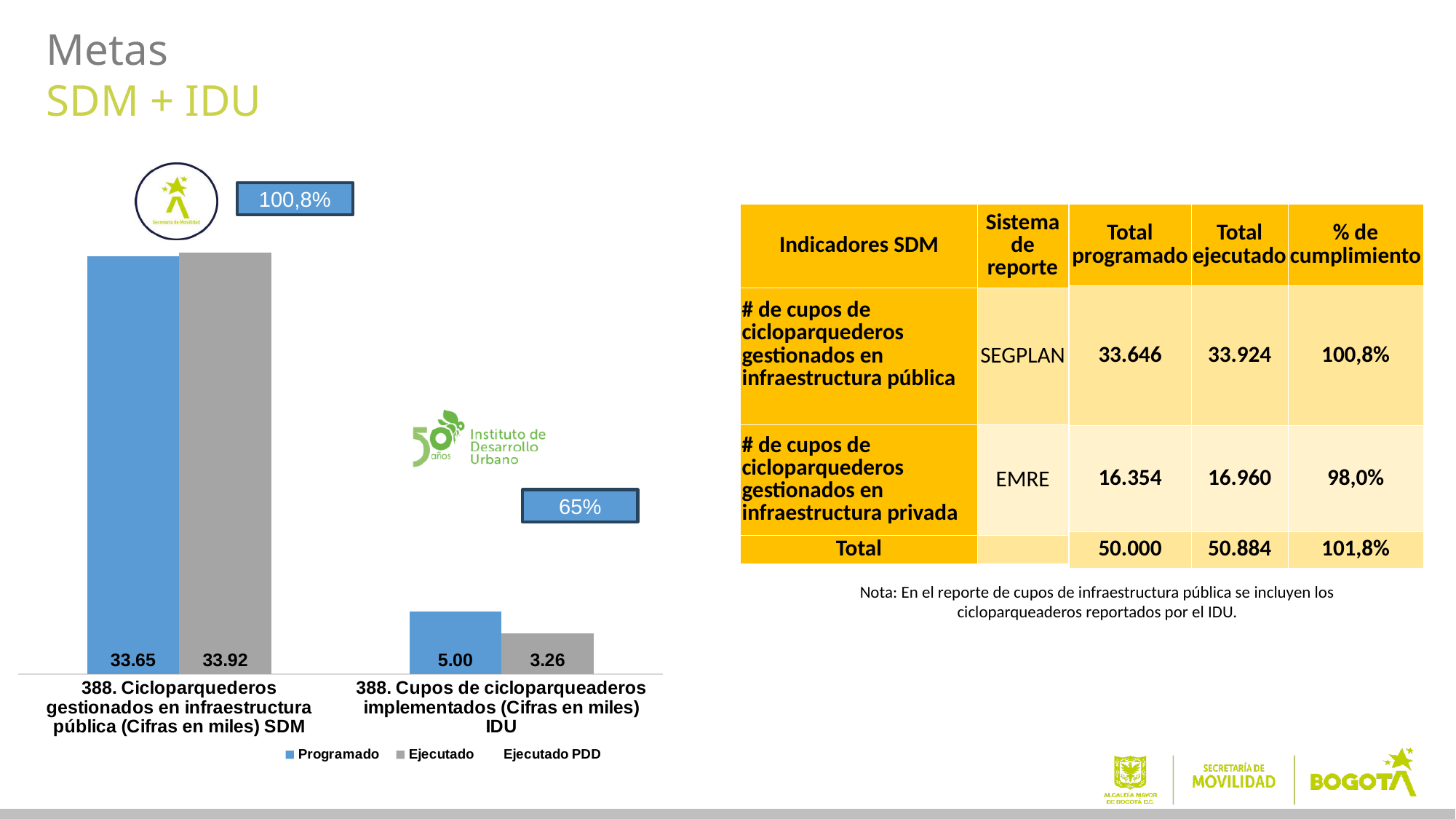
What percentage is shown in the box above the SDM bars? 100,8% How many series does the chart legend list? 3 What is the Programado value for '388. Cupos de cicloparqueaderos implementados (Cifras en miles) IDU'? 5.00 For the SDM category, which is larger: Programado or Ejecutado? Ejecutado Which category has the lowest Ejecutado value? 388. Cupos de cicloparqueaderos implementados (Cifras en miles) IDU What is the Ejecutado value for '388. Cupos de cicloparqueaderos implementados (Cifras en miles) IDU'? 3.26 What is the Ejecutado value for '388. Cicloparquederos gestionados en infraestructura pública (Cifras en miles) SDM'? 33.92 Which category has the highest Programado value? 388. Cicloparquederos gestionados en infraestructura pública (Cifras en miles) SDM How many categories are shown on the x axis of the chart? 2 What is the Programado value for '388. Cicloparquederos gestionados en infraestructura pública (Cifras en miles) SDM'? 33.65 What type of chart is shown on the slide? bar chart What is the difference between the Programado and Ejecutado values for the IDU category? 1.74